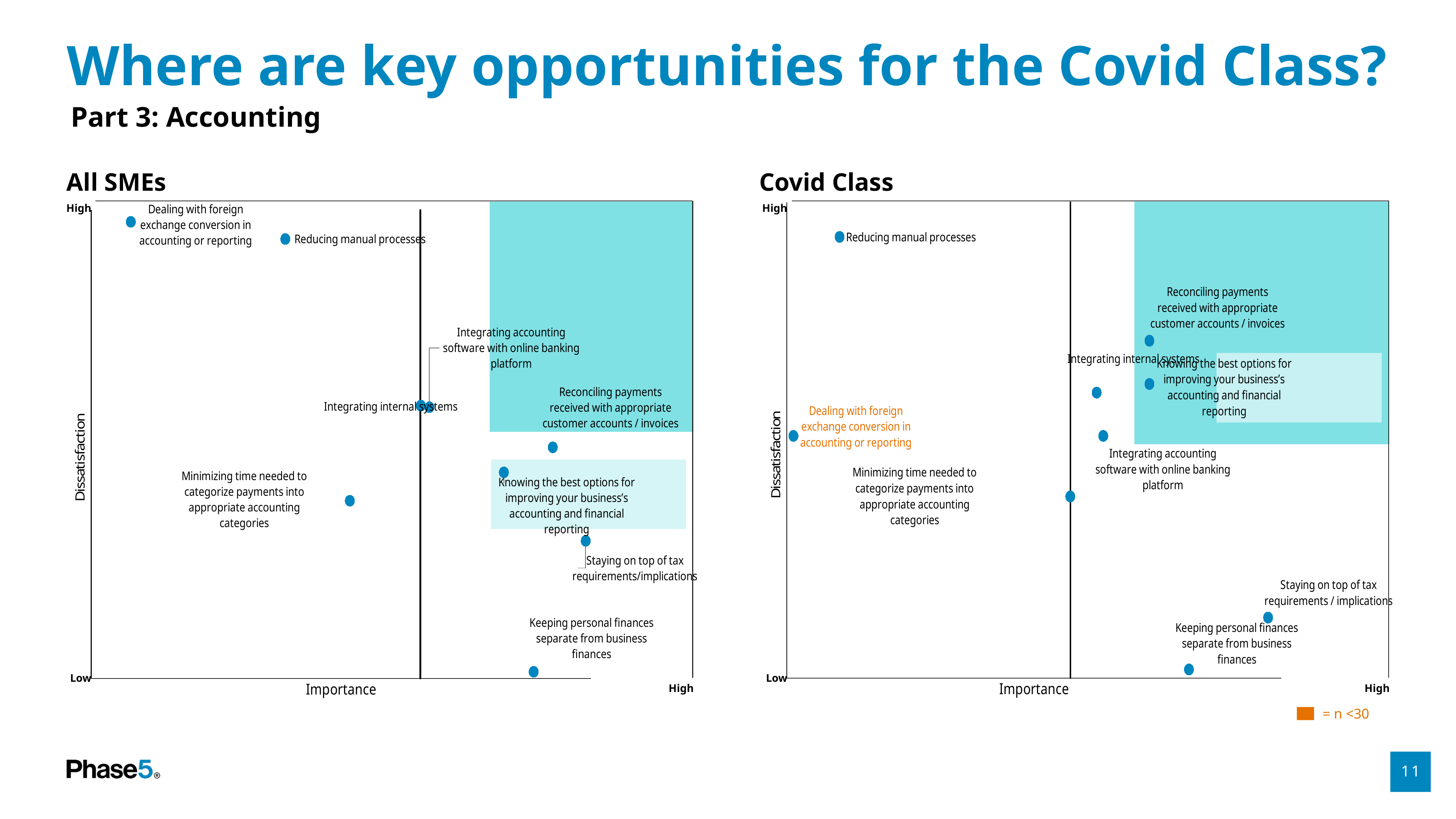
On the Covid Class chart, what does the orange colour indicate according to the legend? n <30 How many data points are plotted on the Covid Class chart? 9 On the Covid Class chart, which item has the lowest dissatisfaction? Keeping personal finances separate from business finances What kind of chart is the All SMEs chart? Scatter chart On the Covid Class chart, which item has the highest dissatisfaction? Reducing manual processes On the Covid Class chart, which item has the highest importance? Staying on top of tax requirements / implications On the Covid Class chart, which item has the lowest importance? Dealing with foreign exchange conversion in accounting or reporting On the All SMEs chart, which has higher dissatisfaction: Reducing manual processes or Minimizing time needed to categorize payments into appropriate accounting categories? Reducing manual processes What is the label of the horizontal axis on the Covid Class chart? Importance How many data points are plotted on the All SMEs chart? 9 On the All SMEs chart, which item has the highest dissatisfaction? Dealing with foreign exchange conversion in accounting or reporting On the All SMEs chart, which item has the lowest dissatisfaction? Keeping personal finances separate from business finances